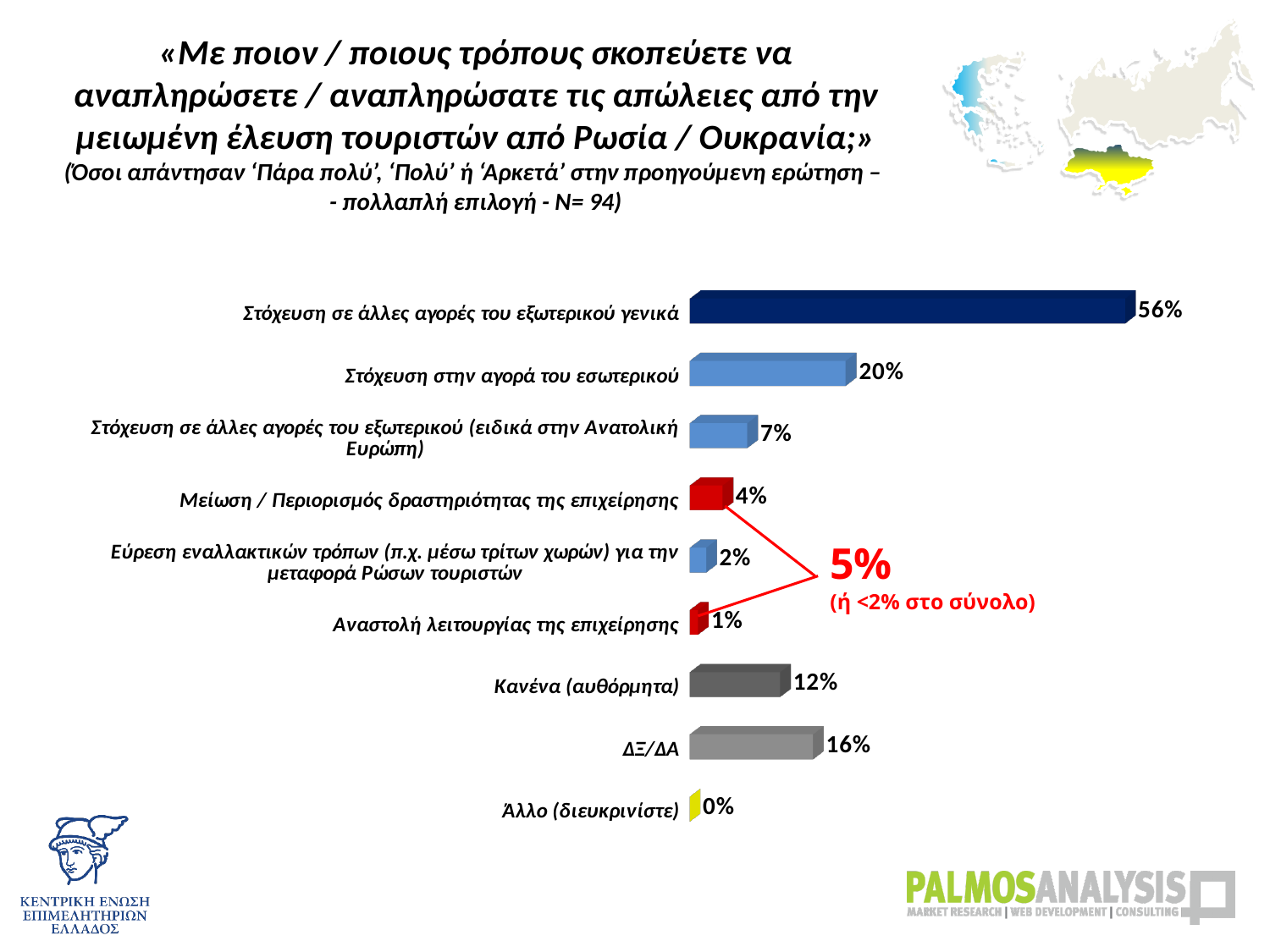
What combined percentage does the red annotation give for «Μείωση / Περιορισμός δραστηριότητας της επιχείρησης» and «Αναστολή λειτουργίας της επιχείρησης»? 5% What percentage is shown for «Στόχευση στην αγορά του εσωτερικού»? 20% What kind of chart is shown on the slide? Bar chart What is the difference between the values for «Στόχευση σε άλλες αγορές του εξωτερικού γενικά» and «Στόχευση στην αγορά του εσωτερικού»? 36% What value is shown for «Κανένα (αυθόρμητα)»? 12% What value is shown for «Αναστολή λειτουργίας της επιχείρησης»? 1% Which category has the lowest value in the chart? Άλλο (διευκρινίστε) What percentage is shown for «Στόχευση σε άλλες αγορές του εξωτερικού γενικά»? 56% What value is shown for «ΔΞ/ΔΑ»? 16% Which is larger: the value for «ΔΞ/ΔΑ» or the value for «Κανένα (αυθόρμητα)»? ΔΞ/ΔΑ How many categories are shown in the chart? 9 Which category has the highest value in the chart? Στόχευση σε άλλες αγορές του εξωτερικού γενικά